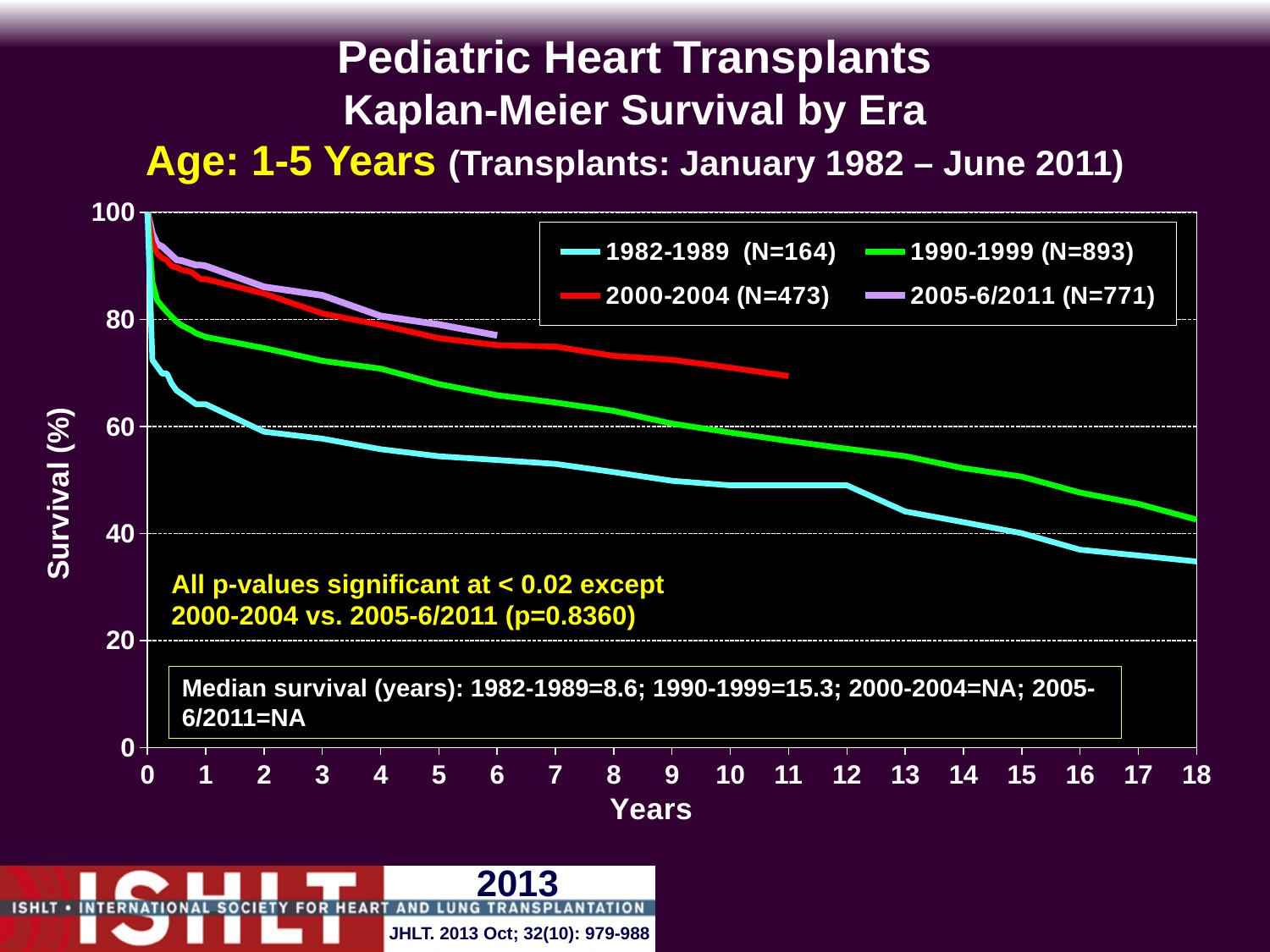
At 5 years, which era has higher survival, 1982-1989 or 1990-1999? 1990-1999 What kind of chart is shown on the slide? line chart Is the survival for the 2005-6/2011 era at 6 years greater or less than 60? greater Is the survival for the 2000-2004 era at 11 years greater or less than 60? greater What is the median survival in years for the 1982-1989 era? 8.6 Do the survival curves rise or fall as years increase? fall How many series does the legend list? 4 What is the N for the 1982-1989 era shown in the legend? 164 Is the survival for the 1982-1989 era at 18 years greater or less than 40? less What is the median survival in years for the 1990-1999 era? 15.3 What p-value is given for 2000-2004 vs. 2005-6/2011? 0.8360 What is the median survival for the 2000-2004 era? NA